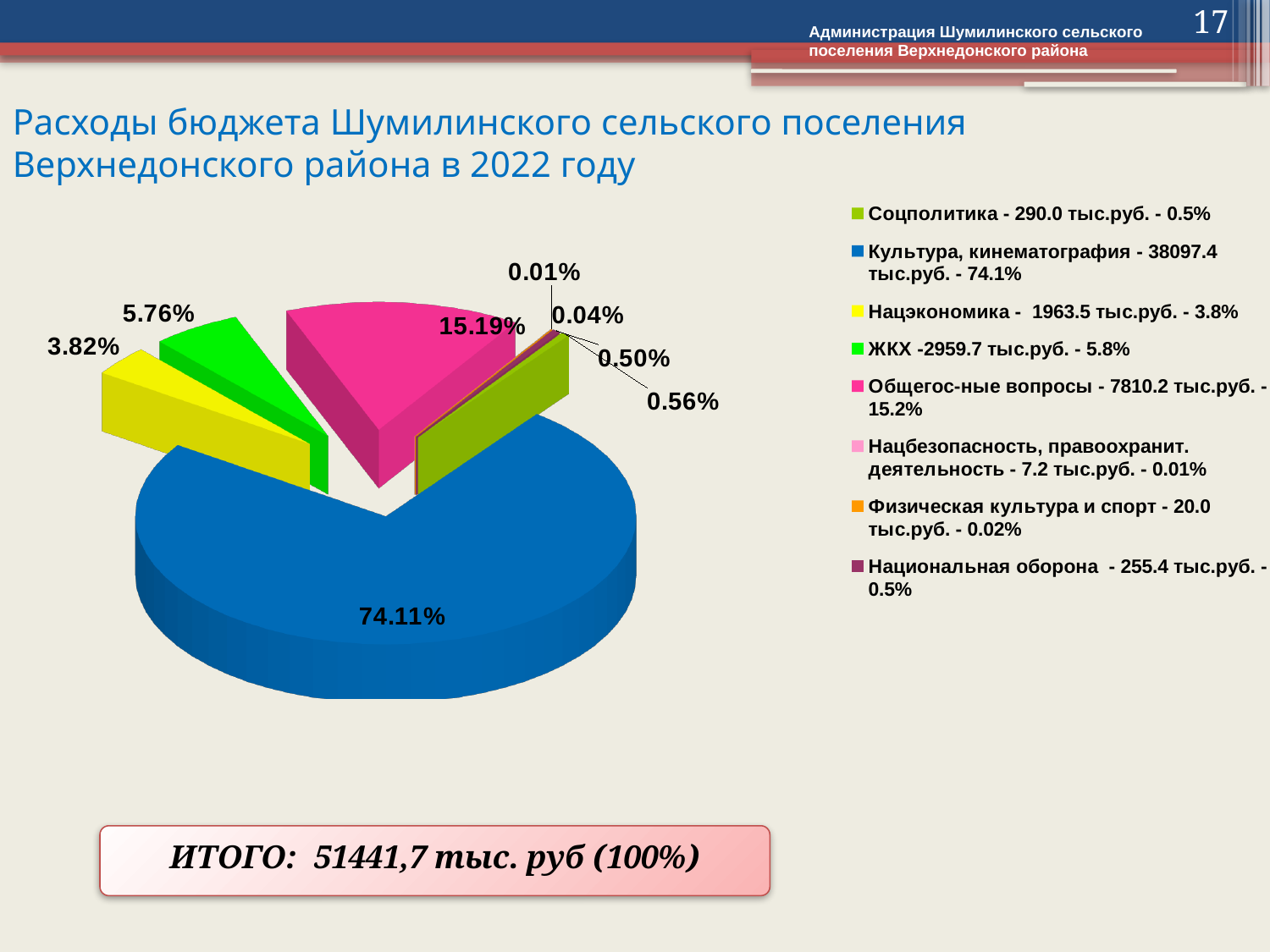
What is the difference in percentage points between the slice labelled 74.11% and the slice labelled 15.19%? 58.92% What percentage is labelled on the largest slice of the pie chart (Культура, кинематография)? 74.11% Which category has the largest share of the pie chart? Культура, кинематография What colour is the slice for Культура, кинематография in the pie chart? Blue What total amount (ИТОГО) is shown below the pie chart? 51441,7 тыс. руб (100%) How many expenditure categories does the legend of the pie chart list? 8 Which has the larger share: ЖКХ or Нацэкономика? ЖКХ According to the legend, what percentage share does Нацэкономика have? 3.8% What percentage is labelled on the pie slice for Общегос-ные вопросы? 15.19% According to the legend, what amount in тыс.руб. is spent on ЖКХ? 2959.7 тыс.руб. Which category has the smallest share of the pie chart? Нацбезопасность, правоохранит. деятельность What kind of chart is shown on the slide? Pie chart